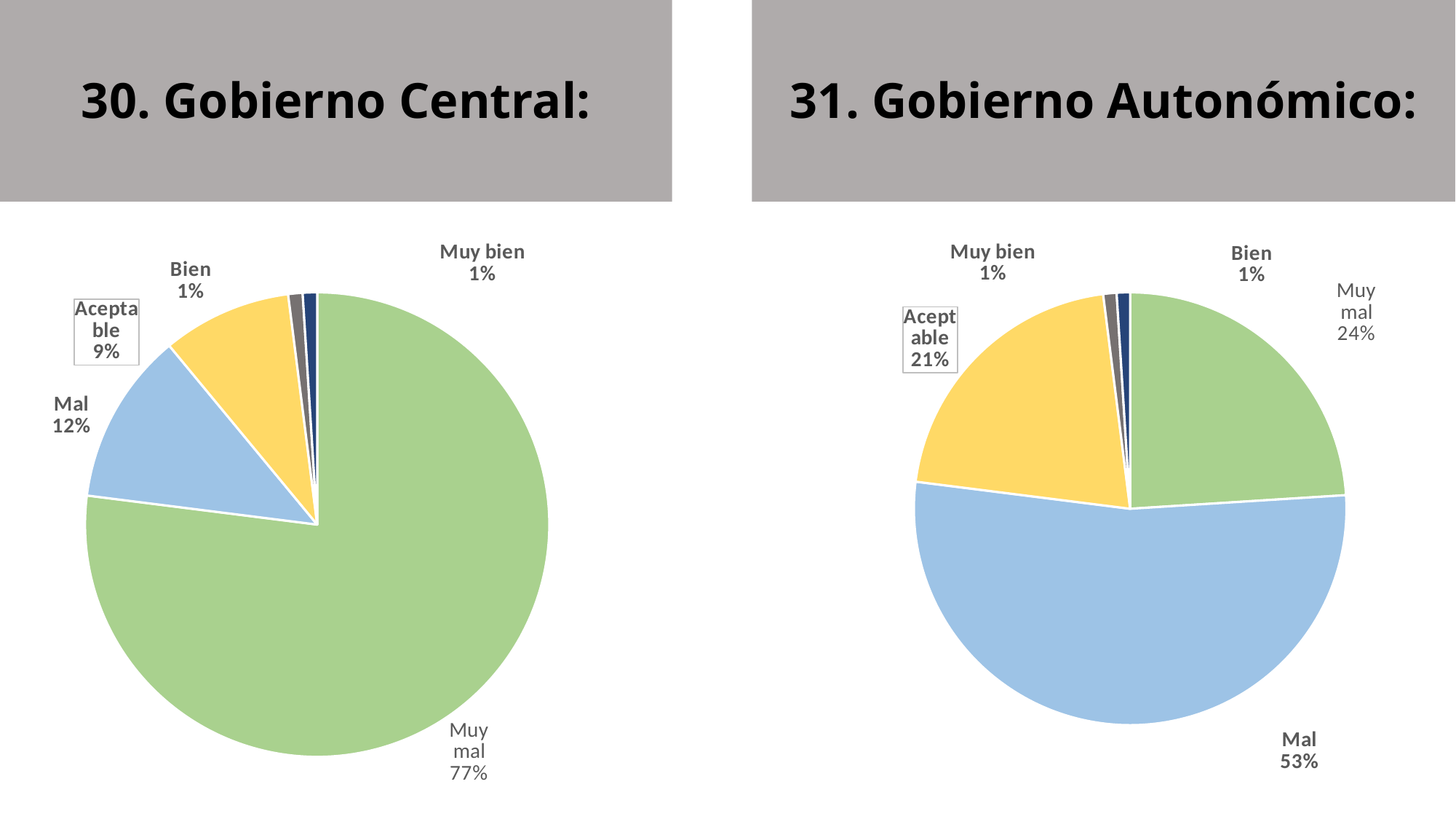
In the '30. Gobierno Central' chart, which category has the largest slice? Muy mal In the '31. Gobierno Autonómico' chart, what share does 'Mal' have? 53% In the '30. Gobierno Central' chart, what share does 'Mal' have? 12% How many slices does the '31. Gobierno Autonómico' chart have? 5 In the '31. Gobierno Autonómico' chart, what is the difference between the 'Mal' and 'Muy mal' shares? 29% In the '31. Gobierno Autonómico' chart, what share does 'Aceptable' have? 21% In the '30. Gobierno Central' chart, which is larger, 'Mal' or 'Aceptable'? Mal In the '31. Gobierno Autonómico' chart, what share does 'Muy mal' have? 24% In the '30. Gobierno Central' chart, what share does 'Aceptable' have? 9% In the '31. Gobierno Autonómico' chart, which category has the largest slice? Mal In the '30. Gobierno Central' chart, what share does 'Muy mal' have? 77% What kind of chart is used for '30. Gobierno Central'? Pie chart